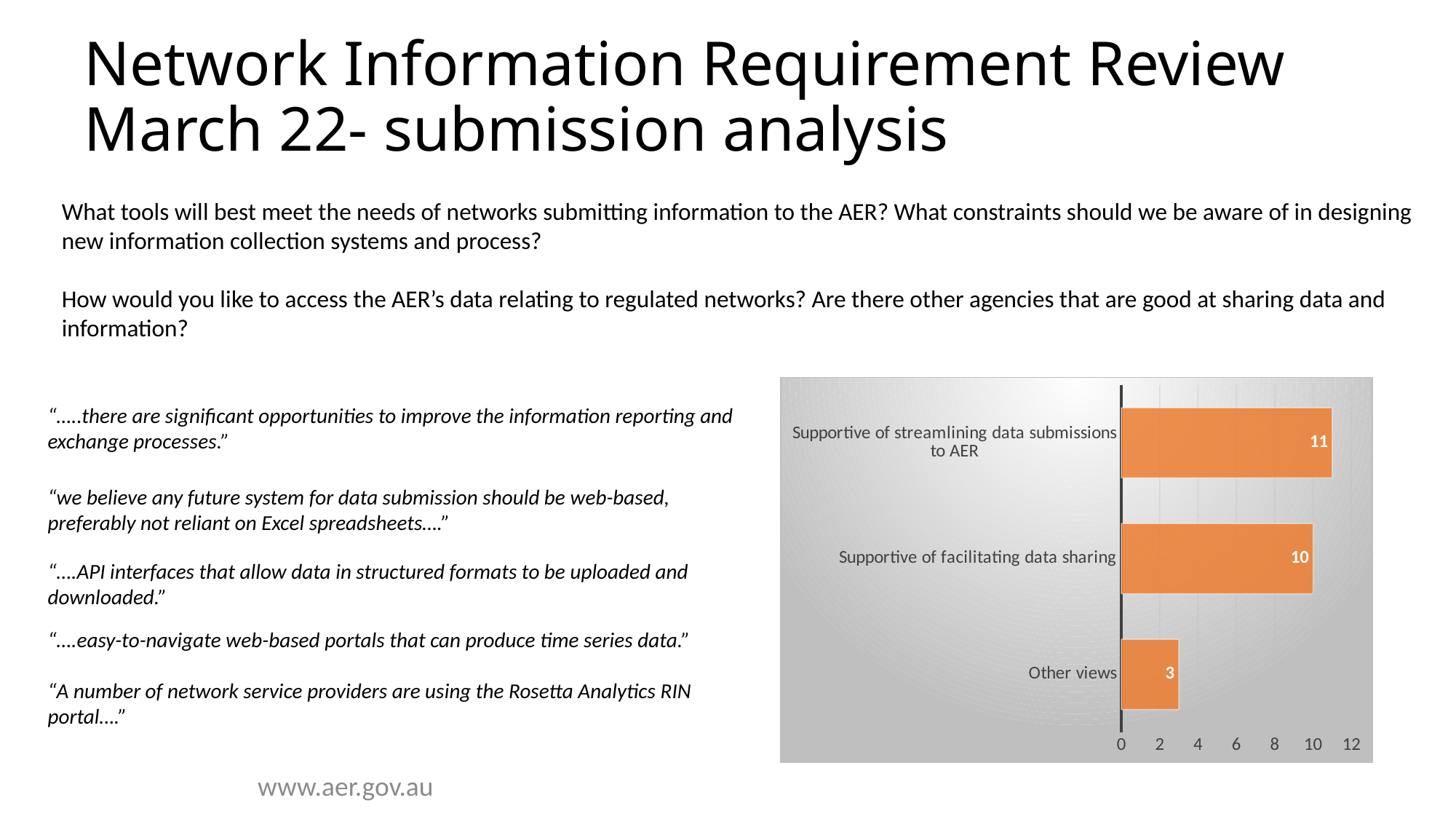
What colour are the bars in the chart? Orange Which is larger: the value for 'Supportive of facilitating data sharing' or the value for 'Other views'? Supportive of facilitating data sharing What kind of chart is shown on the slide? Bar chart What is the difference between the values for 'Supportive of facilitating data sharing' and 'Other views'? 7 What is the value for 'Supportive of facilitating data sharing'? 10 What is the difference between the values for 'Supportive of streamlining data submissions to AER' and 'Other views'? 8 Which category has the lowest value? Other views How many categories are shown in the chart? 3 Which category has the highest value? Supportive of streamlining data submissions to AER Is the value for 'Other views' greater or less than 4? less What is the value for 'Other views'? 3 What is the value for 'Supportive of streamlining data submissions to AER'? 11